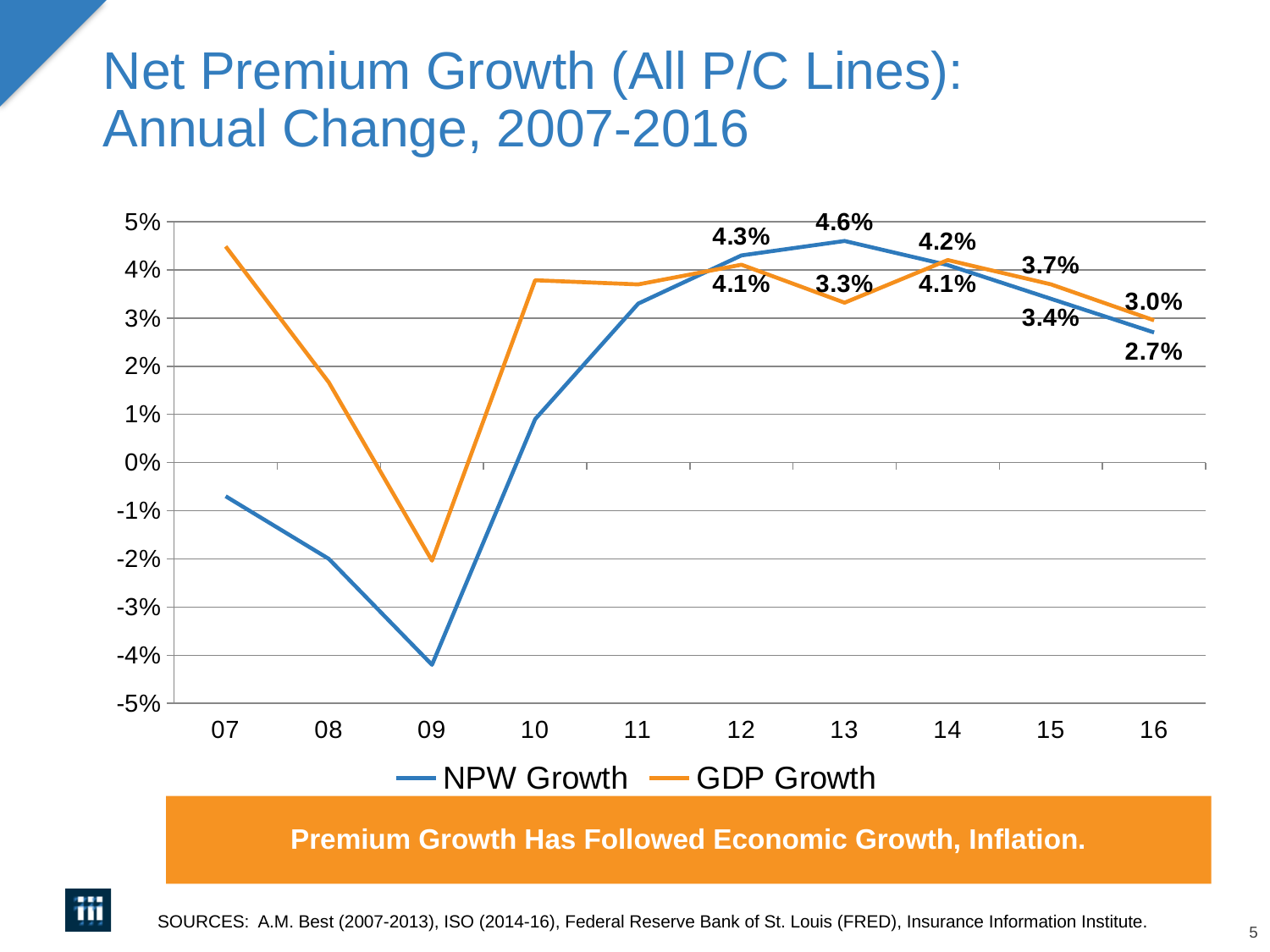
What kind of chart is shown on the slide? Line chart What is the difference between NPW Growth and GDP Growth in 2013? 1.3 percentage points What is the GDP Growth value for 2016? 3.0% What is the NPW Growth value for 2013? 4.6% How many series does the legend list? 2 What is the GDP Growth value for 2013? 3.3% In 2015, which series has the higher value, NPW Growth or GDP Growth? GDP Growth What is the NPW Growth value for 2016? 2.7% Which series is drawn in orange? GDP Growth Does NPW Growth rise or fall from 2013 to 2016? Fall Is the NPW Growth value for 2009 greater or less than -3%? less How many years are plotted along the x axis? 10